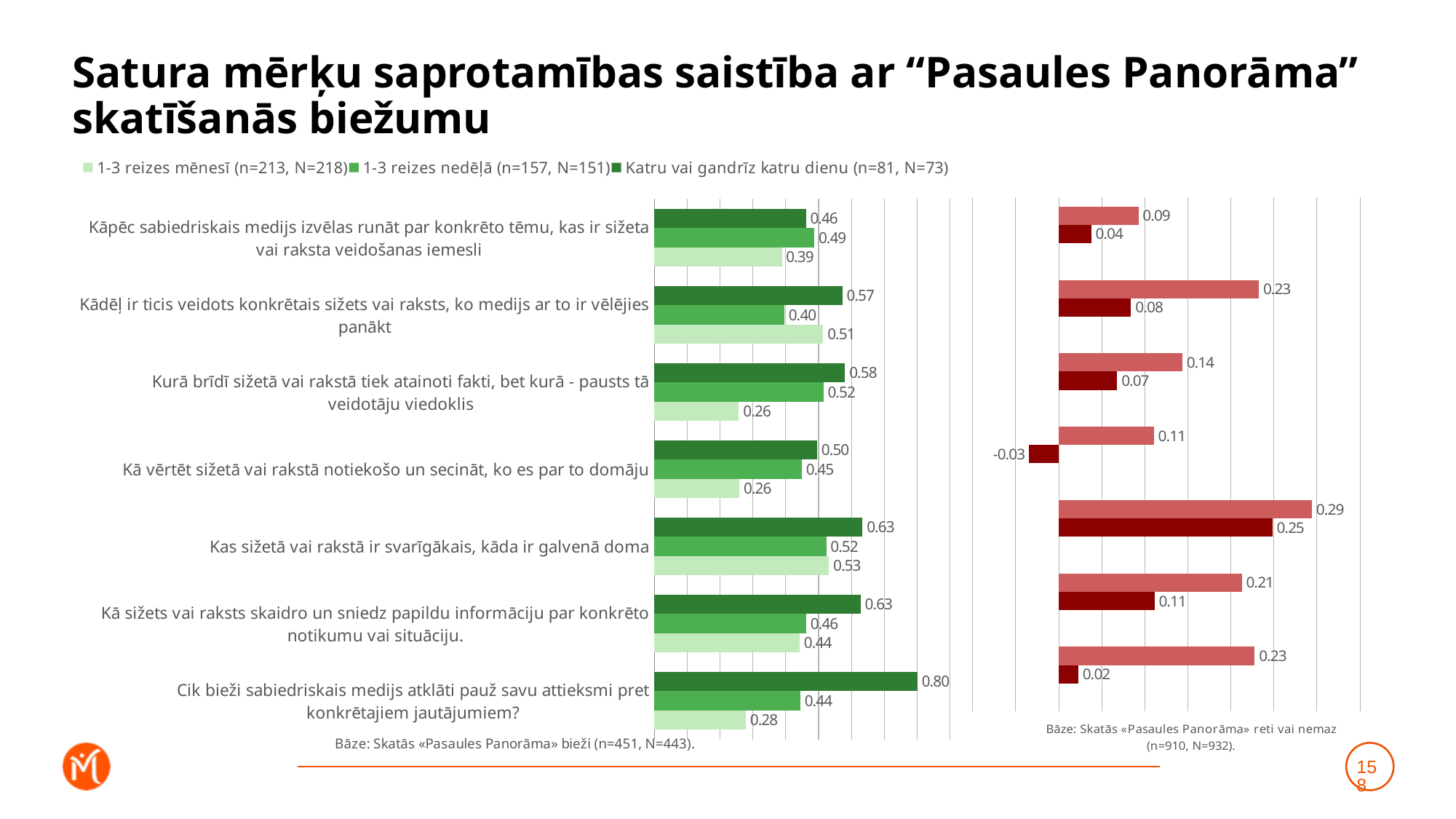
In the left (green) chart, what is the value for "1-3 reizes mēnesī" for the category "Kurā brīdī sižetā vai rakstā tiek atainoti fakti, bet kurā - pausts tā veidotāju viedoklis"? 0.26 In the left (green) chart, which category has the highest value for the "Katru vai gandrīz katru dienu" series? Cik bieži sabiedriskais medijs atklāti pauž savu attieksmi pret konkrētajiem jautājumiem? How many series does the legend list for the left (green) chart? 3 In the left (green) chart, what is the value for "Katru vai gandrīz katru dienu" for the category "Cik bieži sabiedriskais medijs atklāti pauž savu attieksmi pret konkrētajiem jautājumiem?"? 0.80 In the right (red) chart, what is the lowest value shown? -0.03 In the left (green) chart, which category has the lowest value for the "1-3 reizes nedēļā" series? Kādēļ ir ticis veidots konkrētais sižets vai raksts, ko medijs ar to ir vēlējies panākt In the left (green) chart, for "Kādēļ ir ticis veidots konkrētais sižets vai raksts, ko medijs ar to ir vēlējies panākt", which is larger: "1-3 reizes mēnesī" or "1-3 reizes nedēļā"? 1-3 reizes mēnesī In the left (green) chart, what is the value for "1-3 reizes nedēļā" for the category "Kāpēc sabiedriskais medijs izvēlas runāt par konkrēto tēmu, kas ir sižeta vai raksta veidošanas iemesli"? 0.49 In the left (green) chart, for "Cik bieži sabiedriskais medijs atklāti pauž savu attieksmi pret konkrētajiem jautājumiem?", what is the difference between the "Katru vai gandrīz katru dienu" value and the "1-3 reizes nedēļā" value? 0.36 In the right (red) chart, what is the highest value shown? 0.29 How many categories are shown in the left (green) chart? 7 What kind of chart is the left (green) chart? Bar chart